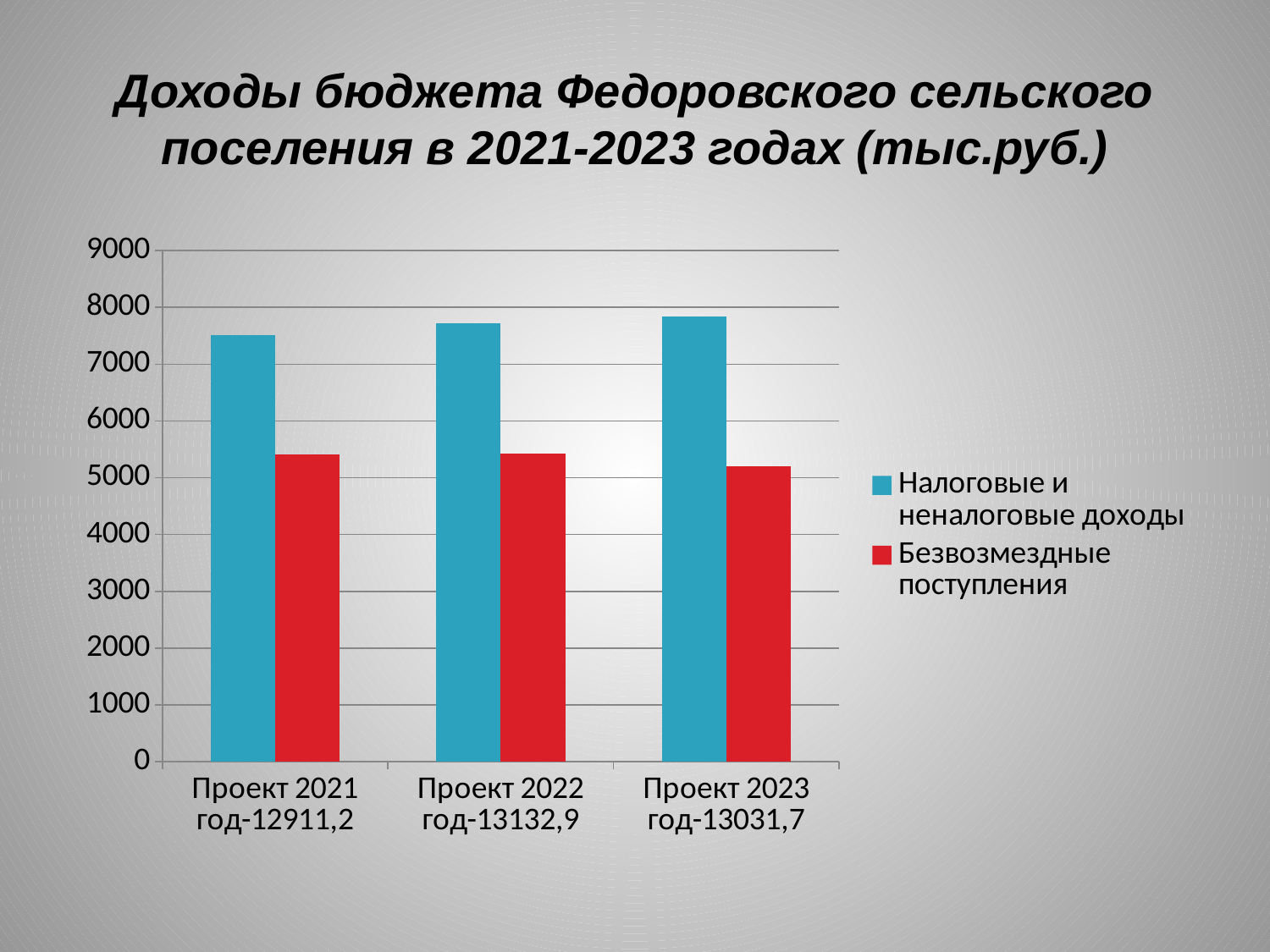
Is the value for Безвозмездные поступления in Проект 2023 год greater or less than 6000? less How many categories are shown on the x axis? 3 What kind of chart is shown on the slide? bar chart In which category is the value for Безвозмездные поступления the lowest? Проект 2023 год Do the values for Налоговые и неналоговые доходы rise or fall from Проект 2021 год to Проект 2023 год? rise Is the value for Налоговые и неналоговые доходы in Проект 2023 год greater or less than 8000? less Which series has the larger value in Проект 2022 год: Налоговые и неналоговые доходы or Безвозмездные поступления? Налоговые и неналоговые доходы Which colour represents Безвозмездные поступления in the legend? red What total amount is printed in the x-axis label for Проект 2022 год? 13132,9 How many series does the legend list? 2 In which category is the value for Налоговые и неналоговые доходы the lowest? Проект 2021 год Is the value for Налоговые и неналоговые доходы in Проект 2021 год greater or less than 7000? greater